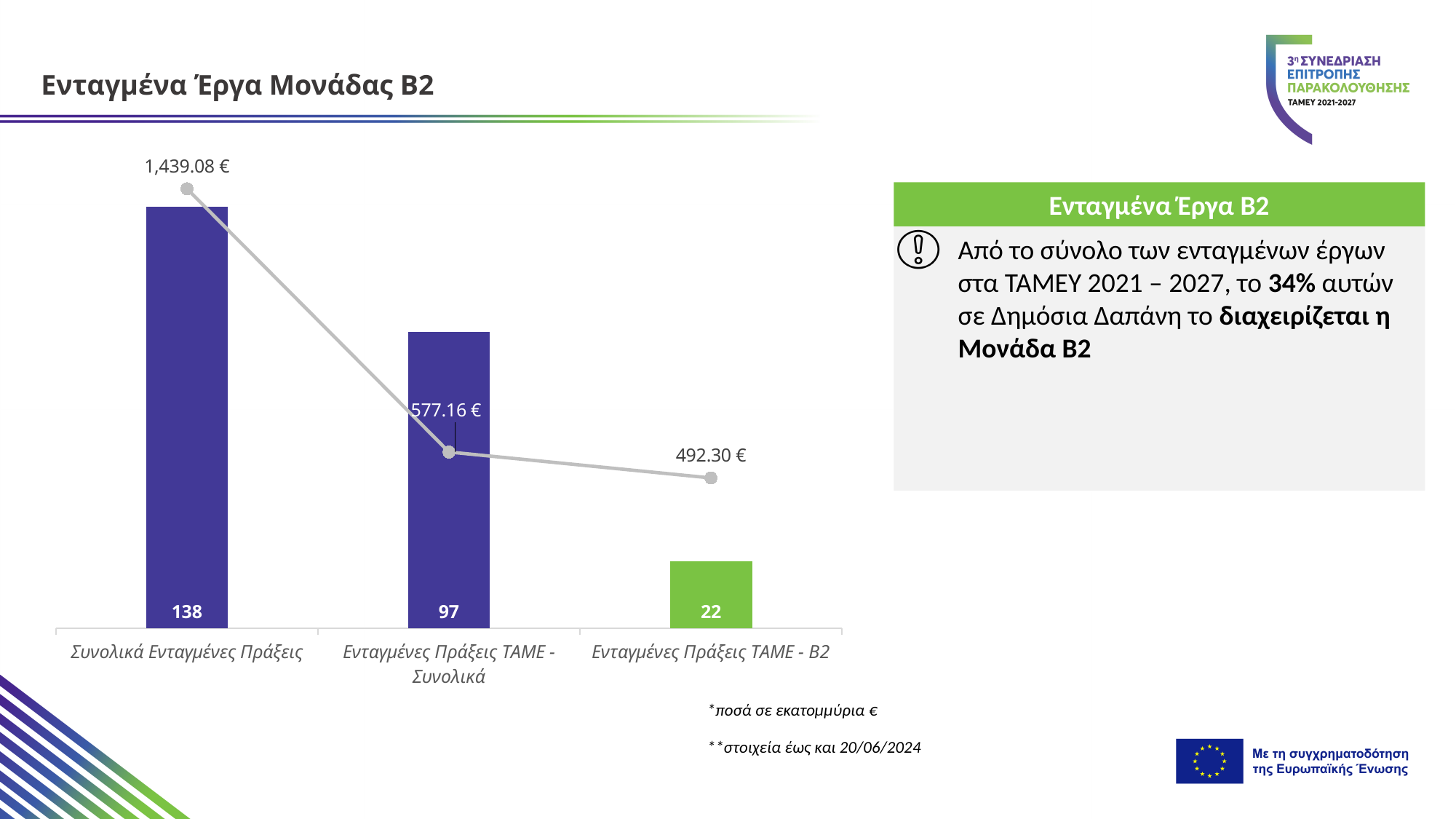
What is the number of projects shown on the bar for Ενταγμένες Πράξεις ΤΑΜΕ - Β2? 22 Do the bar values rise or fall from left to right along the x axis? fall What is the number of projects shown on the bar for Ενταγμένες Πράξεις ΤΑΜΕ - Συνολικά? 97 Which category has the lowest line value? Ενταγμένες Πράξεις ΤΑΜΕ - Β2 What amount does the line show for Ενταγμένες Πράξεις ΤΑΜΕ - Β2? 492.30 € What is the difference between the bar values for Συνολικά Ενταγμένες Πράξεις and Ενταγμένες Πράξεις ΤΑΜΕ - Συνολικά? 41 How many categories are shown on the x axis? 3 Which category has the highest bar value? Συνολικά Ενταγμένες Πράξεις What amount does the line show for Συνολικά Ενταγμένες Πράξεις? 1,439.08 € What is the number of projects shown on the bar for Συνολικά Ενταγμένες Πράξεις? 138 What colour is the bar for Ενταγμένες Πράξεις ΤΑΜΕ - Β2? green Which is larger, the line value for Ενταγμένες Πράξεις ΤΑΜΕ - Συνολικά or for Ενταγμένες Πράξεις ΤΑΜΕ - Β2? Ενταγμένες Πράξεις ΤΑΜΕ - Συνολικά